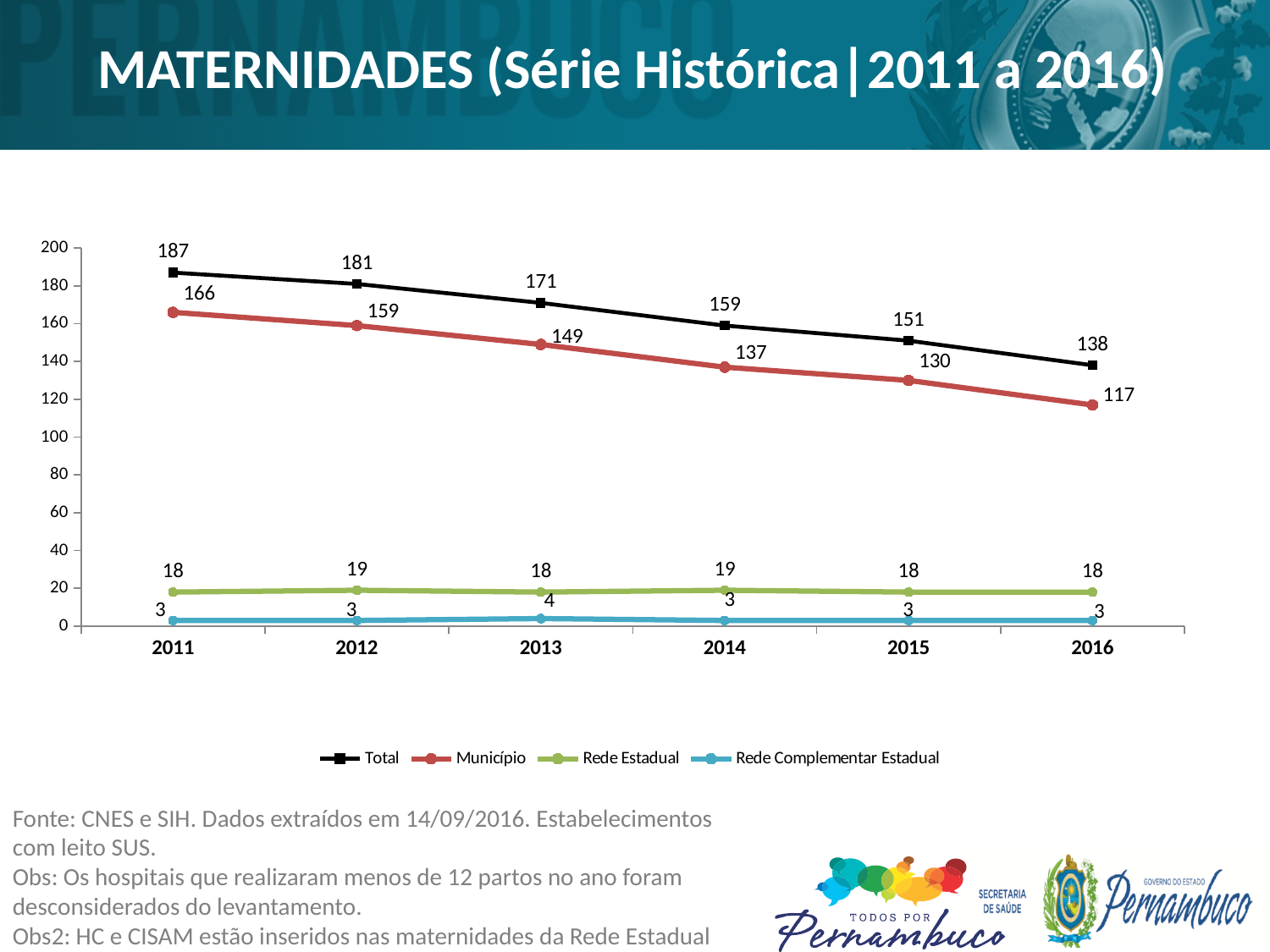
What kind of chart is shown on the slide? line chart What is the value of the Município series in 2016? 117 How many series does the legend list? 4 What is the value of Rede Estadual in 2014? 19 How many years are shown on the x axis? 6 In which year is the Município series lowest? 2016 In which year is the Total series highest? 2011 What is the value of Rede Complementar Estadual in 2013? 4 Does the Total series rise or fall from 2011 to 2016? fall Which is larger, the Município value in 2013 or in 2015? 2013 What is the value of the Total series in 2011? 187 What is the difference between the Total values in 2011 and 2016? 49